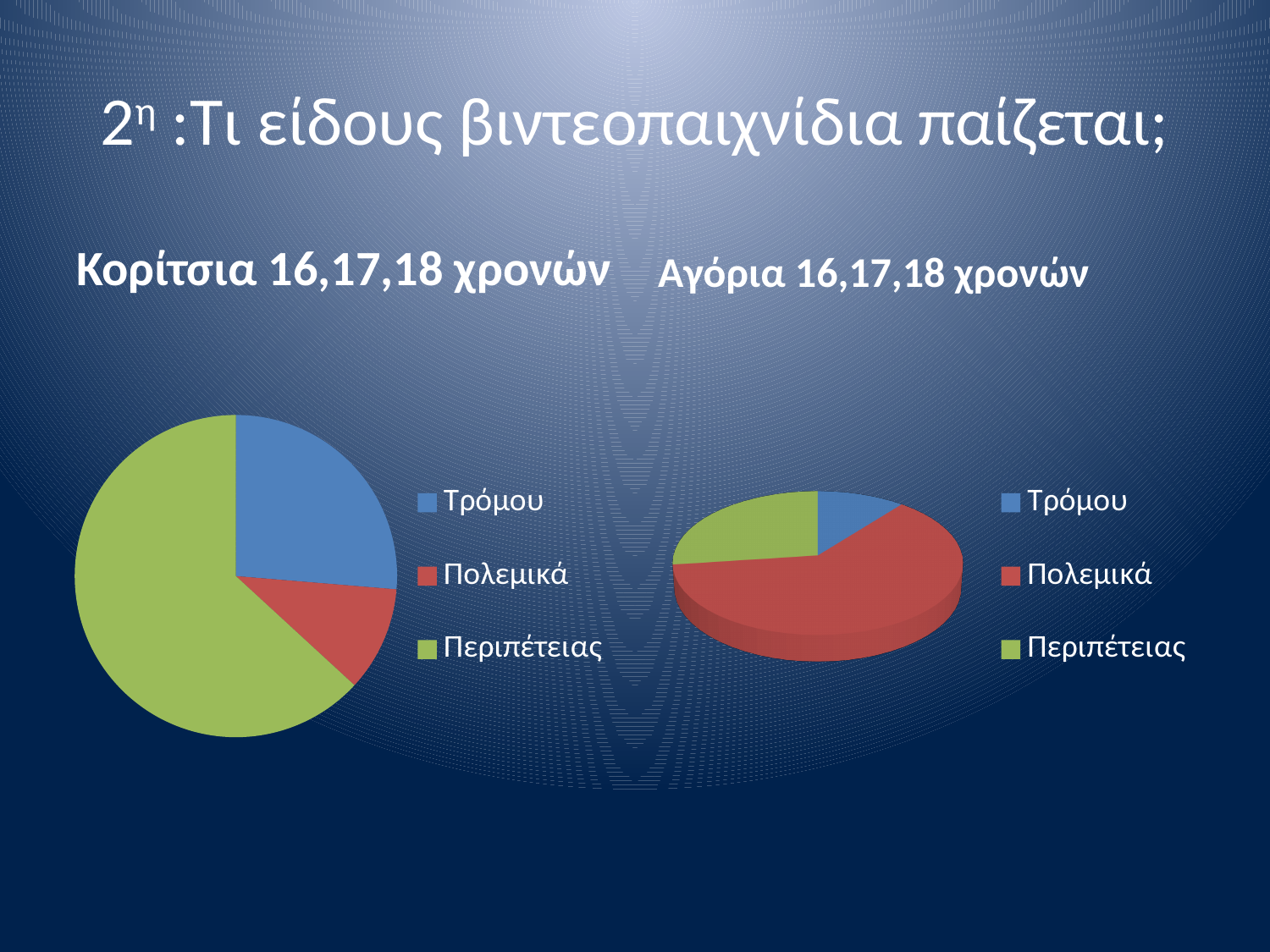
In the right chart (Αγόρια 16,17,18 χρονών), how many categories does the legend list? 3 In the left chart (Κορίτσια 16,17,18 χρονών), which category has the largest slice? Περιπέτειας What colour represents Πολεμικά in the legend of the right chart (Αγόρια 16,17,18 χρονών)? red In the left chart (Κορίτσια 16,17,18 χρονών), which category has the smallest slice? Πολεμικά What kind of chart is the left chart titled "Κορίτσια 16,17,18 χρονών"? pie chart In the left chart (Κορίτσια 16,17,18 χρονών), which slice is larger: Περιπέτειας or Τρόμου? Περιπέτειας In the left chart (Κορίτσια 16,17,18 χρονών), which slice is larger: Τρόμου or Πολεμικά? Τρόμου What is the title of the left chart? Κορίτσια 16,17,18 χρονών In the left chart (Κορίτσια 16,17,18 χρονών), how many slices does the pie have? 3 In the right chart (Αγόρια 16,17,18 χρονών), which slice is larger: Πολεμικά or Τρόμου? Πολεμικά In the right chart (Αγόρια 16,17,18 χρονών), which category has the largest slice? Πολεμικά What kind of chart is the right chart titled "Αγόρια 16,17,18 χρονών"? pie chart